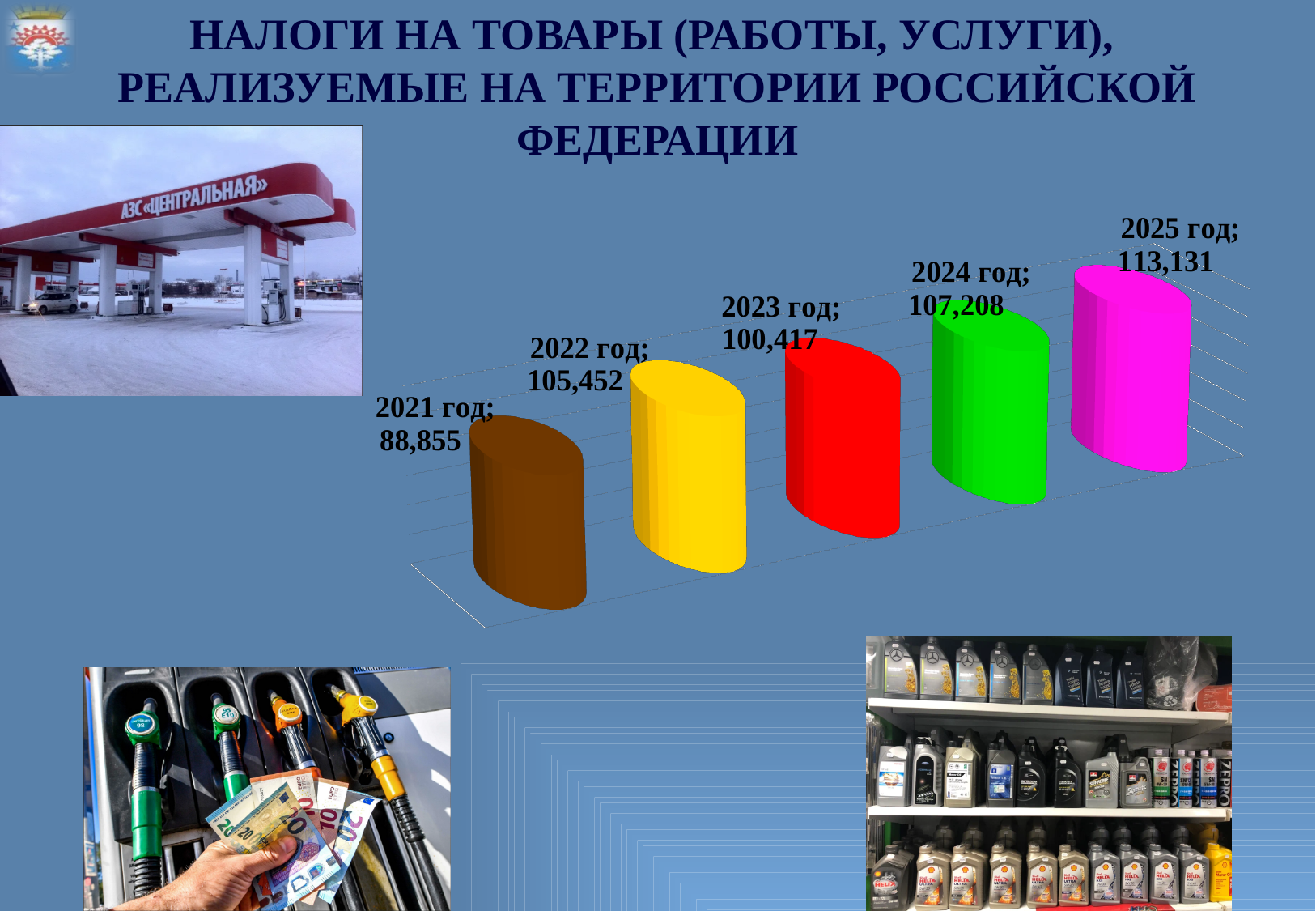
Which is larger, the value for 2022 год or the value for 2023 год? 2022 год How many years are shown in the chart? 5 What is the difference between the values for 2022 год and 2023 год? 5,035 What is the difference between the values for 2025 год and 2021 год? 24,276 What is the value for 2021 год? 88,855 What kind of chart is shown on the slide? bar chart What is the value for 2023 год? 100,417 Which year has the lowest value? 2021 год What is the value for 2025 год? 113,131 What colour is the bar for 2024 год? green Which year has the highest value? 2025 год Does the value rise or fall from 2022 год to 2023 год? fall